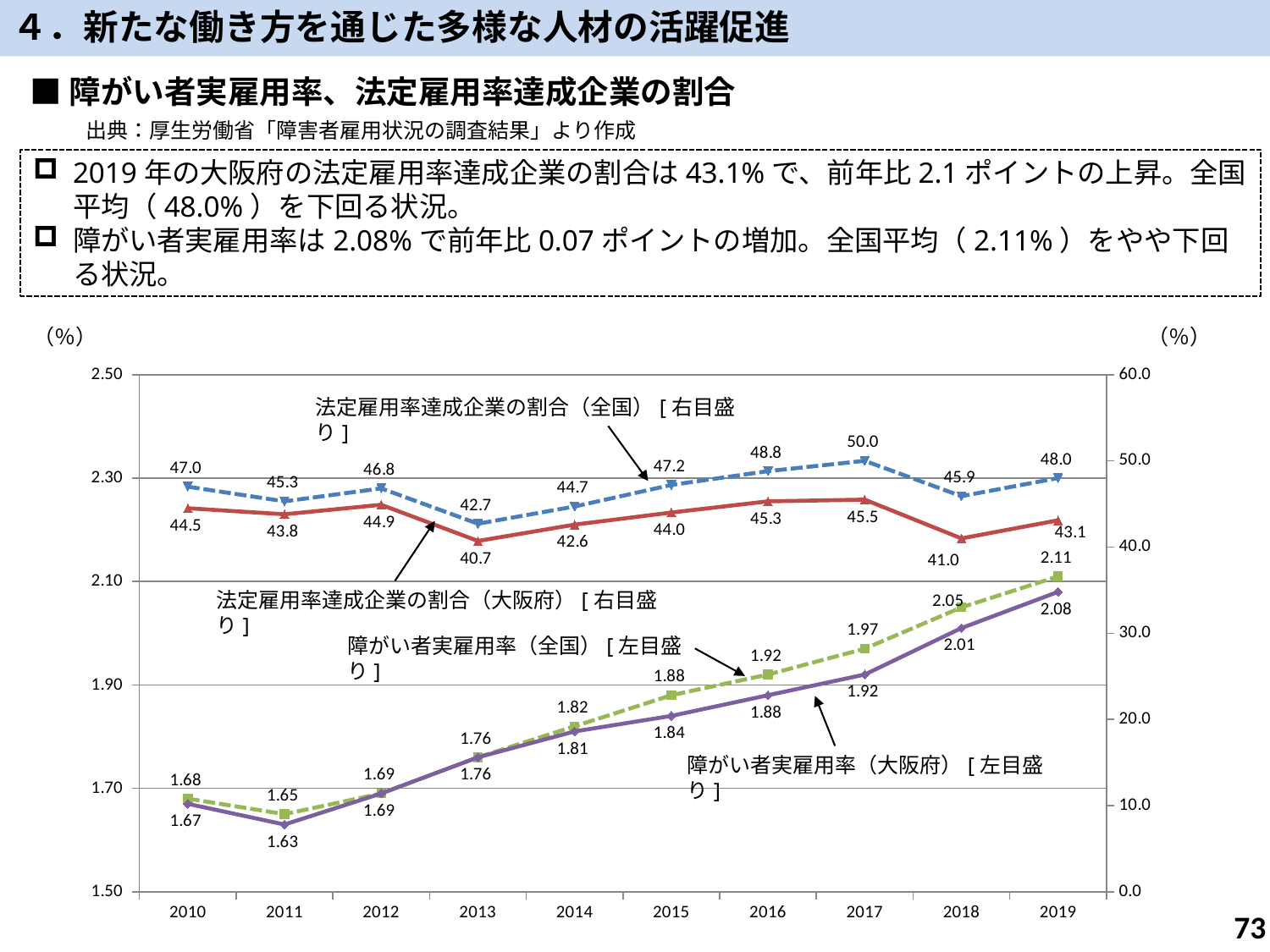
このグラフの種類は何ですか？ 折れ線グラフ 法定雇用率達成企業の割合（大阪府）が最も低いのは何年ですか？ 2013 2017年の法定雇用率達成企業の割合（全国）の値はいくつですか？ 50.0 2013年の法定雇用率達成企業の割合（大阪府）は40.0より大きいですか、小さいですか？ 大きい 法定雇用率達成企業の割合（全国）が最も高いのは何年ですか？ 2017 2019年の障がい者実雇用率について、全国と大阪府の差はいくつですか？ 0.03 2018年の法定雇用率達成企業の割合は、全国と大阪府のどちらが高いですか？ 全国 障がい者実雇用率（全国）は2011年から2019年にかけて上昇していますか、下降していますか？ 上昇 横軸には何年分のデータ点がありますか？ 10 このグラフには何本の系列が描かれていますか？ 4 2019年の法定雇用率達成企業の割合（大阪府）の値はいくつですか？ 43.1 2015年の障がい者実雇用率（大阪府）の値はいくつですか？ 1.84